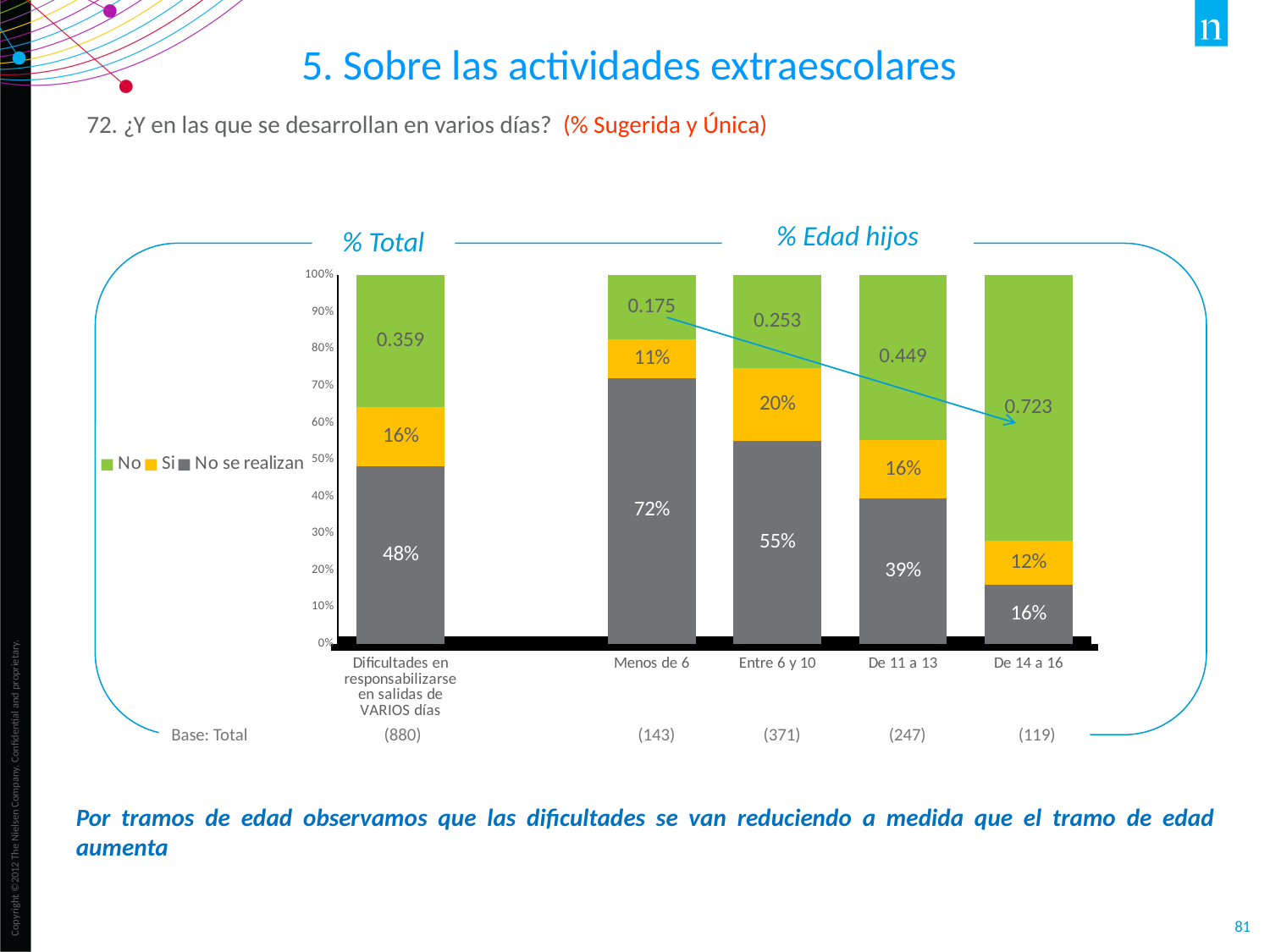
Which category has the highest value for the 'No se realizan' series? Menos de 6 Which category has the lowest value for the 'No' series? Menos de 6 Which is larger: the 'Si' value for 'Entre 6 y 10' or the 'Si' value for 'De 14 a 16'? Entre 6 y 10 What is the difference between the 'No se realizan' values for 'Menos de 6' and 'De 14 a 16'? 56% Does the 'No se realizan' series rise or fall across the age groups from 'Menos de 6' to 'De 14 a 16'? fall What is the value of the 'No se realizan' series for 'Menos de 6'? 72% What is the value of the 'No se realizan' series for the total category 'Dificultades en responsabilizarse en salidas de VARIOS días'? 48% What type of chart is shown on the slide? stacked bar chart How many categories are plotted along the x axis? 5 How many series does the legend list? 3 What is the value of the 'No' series for 'De 14 a 16'? 0.723 What is the value of the 'Si' series for 'Entre 6 y 10'? 20%